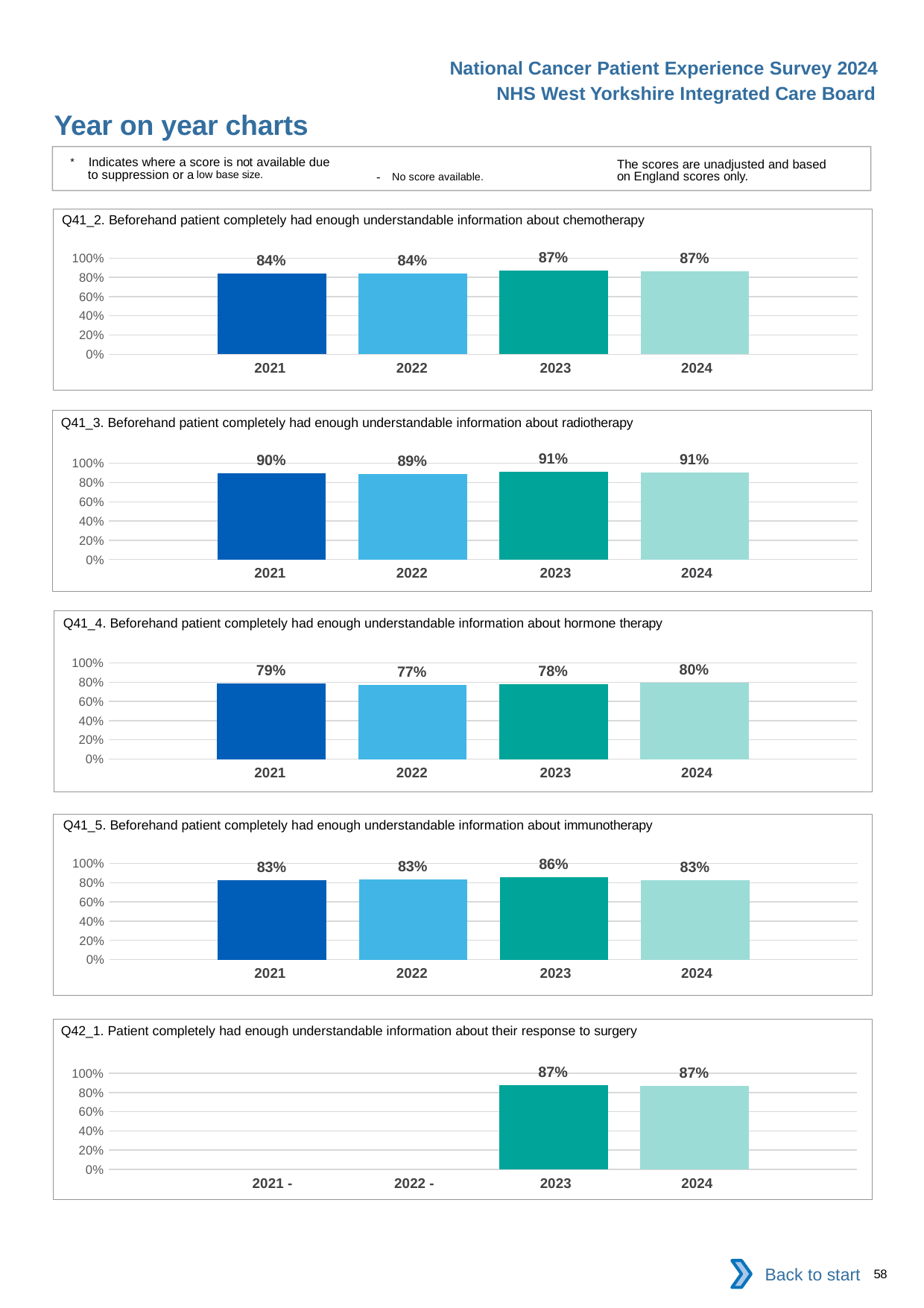
How many charts are shown on the slide? 5 In the Q41_4 chart about hormone therapy, which year has the highest value? 2024 In the Q41_3 chart about radiotherapy, what is the value for 2022? 89% In the Q41_2 chart about chemotherapy, what is the value for 2023? 87% In the Q41_5 chart about immunotherapy, what is the difference between the 2023 value and the 2024 value? 3% In the Q41_5 chart about immunotherapy, which year has the highest value? 2023 In the Q41_4 chart about hormone therapy, which year has the lowest value? 2022 In the Q41_2 chart about chemotherapy, what is the difference between the 2024 value and the 2021 value? 3% In the Q41_3 chart about radiotherapy, which is larger, the value for 2021 or the value for 2022? 2021 In the Q42_1 chart about response to surgery, how many years have a bar plotted? 2 In the Q42_1 chart about response to surgery, what is the value for 2024? 87% What kind of chart is the Q41_2 chart about chemotherapy? Bar chart